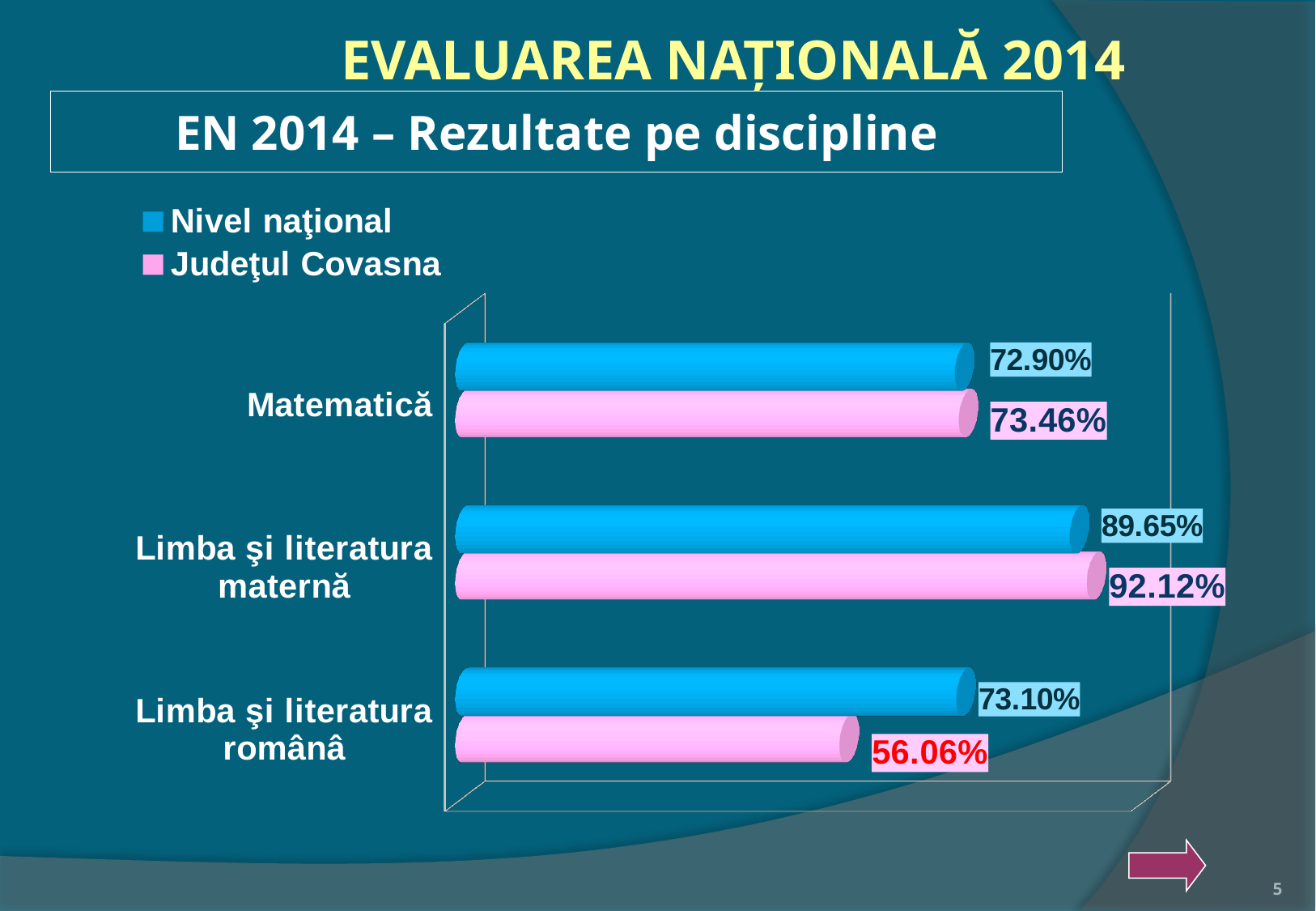
What kind of chart is shown on the slide? bar chart What is the Nivel naţional value for Matematică? 72.90% How many subject categories are shown in the chart? 3 What is the Judeţul Covasna value for Limba şi literatura română? 56.06% For Limba şi literatura română, which is larger: Nivel naţional or Judeţul Covasna? Nivel naţional What is the Nivel naţional value for Limba şi literatura română? 73.10% Which subject has the highest Judeţul Covasna value? Limba şi literatura maternă How many series does the legend list? 2 What is the Judeţul Covasna value for Limba şi literatura maternă? 92.12% What is the difference between the Nivel naţional and Judeţul Covasna values for Limba şi literatura română? 17.04% Which subject has the lowest Judeţul Covasna value? Limba şi literatura română Which series is shown in pink in the legend? Judeţul Covasna